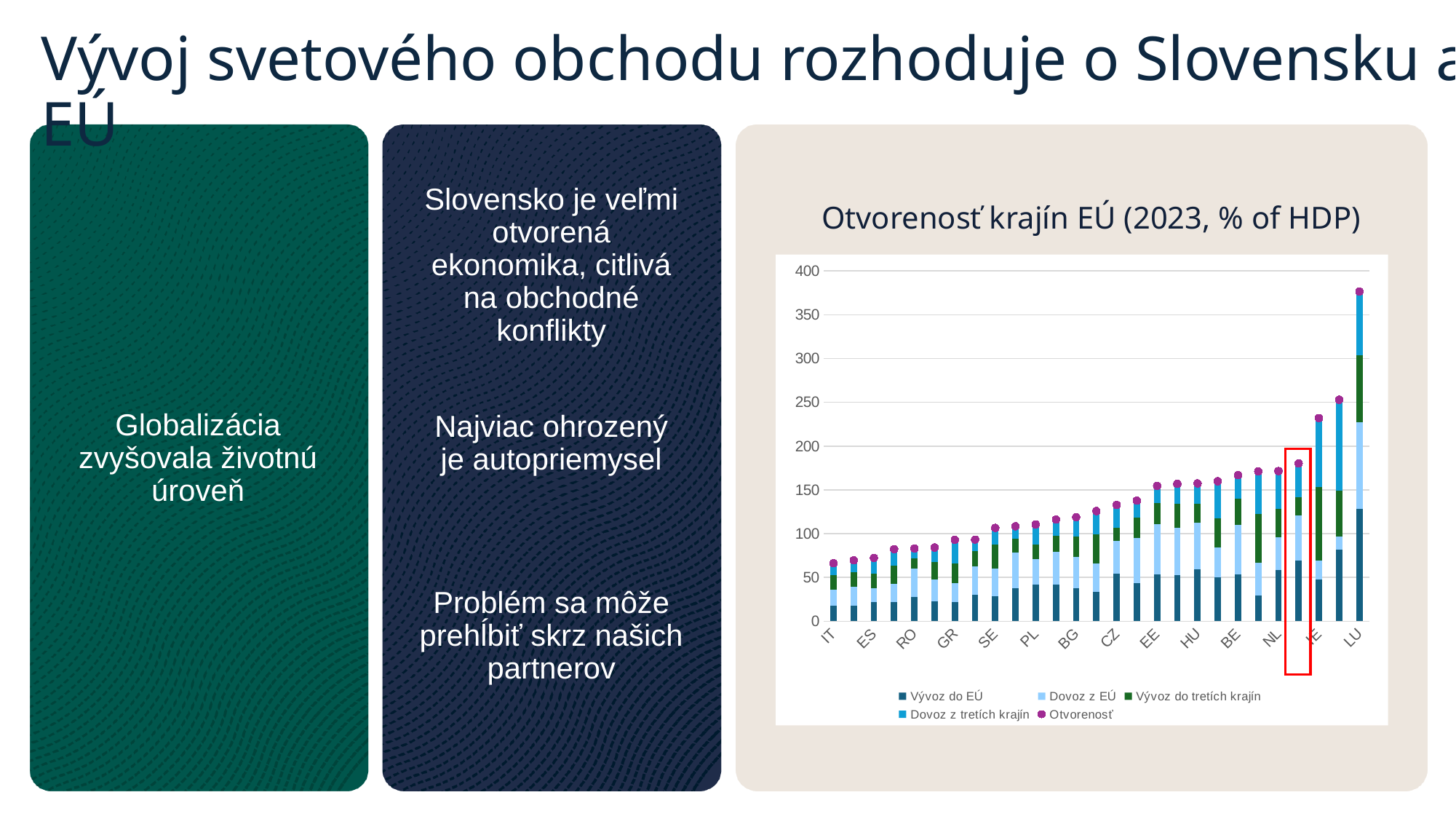
Which has a larger Otvorenosť value, LU or IT? LU Is the Otvorenosť value for LU greater or less than 350? greater Is the Otvorenosť value for ES greater or less than 100? less Is the Otvorenosť value for NL greater or less than 150? greater Which legend entry is shown with a purple marker? Otvorenosť What is the title of the chart on the slide? Otvorenosť krajín EÚ (2023, % of HDP) How many series does the chart legend list? 5 Which country has the highest Otvorenosť value in the chart? LU Do the Otvorenosť values rise or fall from left to right along the x axis? rise What kind of chart is shown on the slide? Stacked bar chart with markers Which country has the lowest Otvorenosť value in the chart? IT